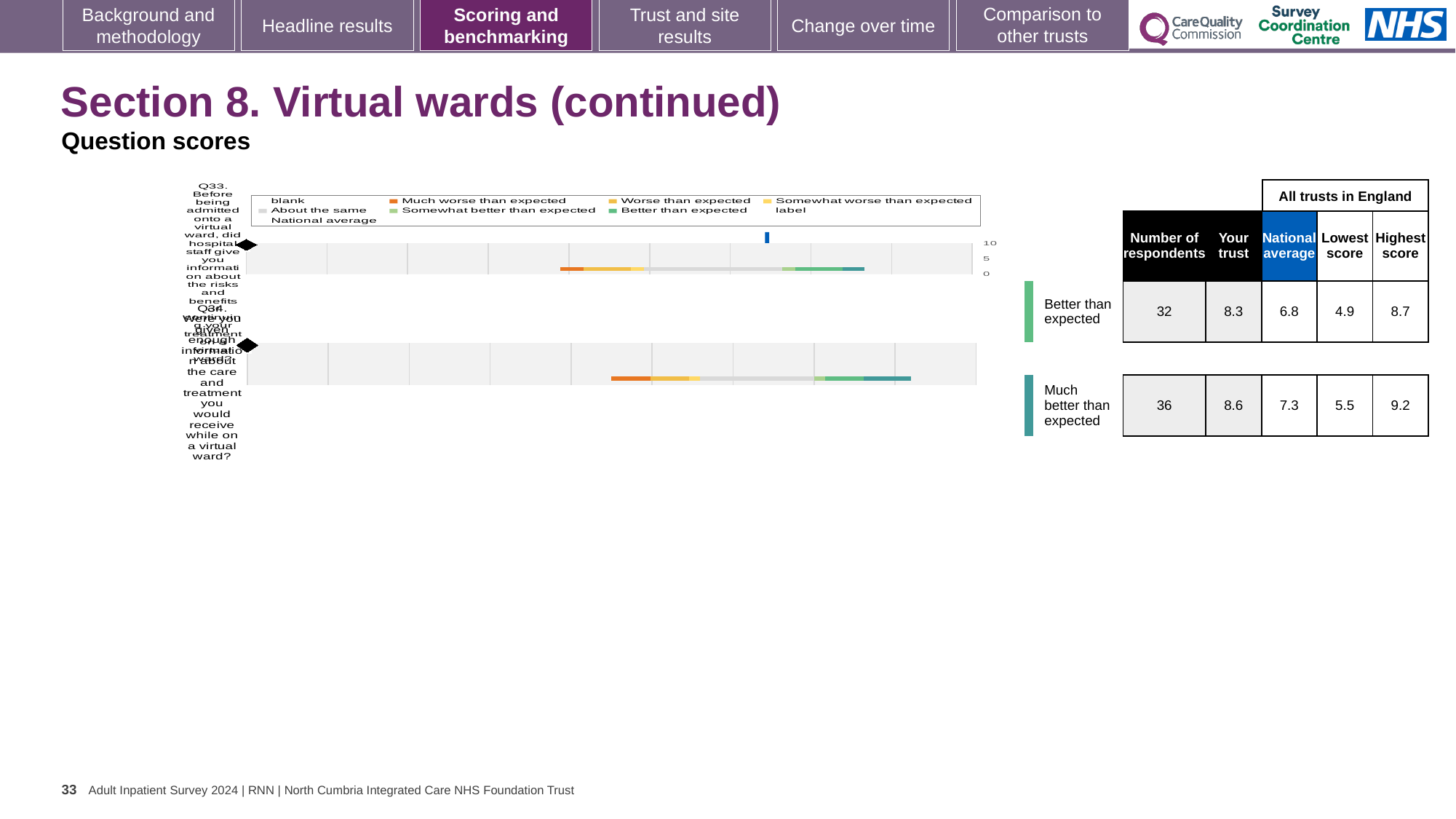
What kind of chart is shown on the slide? bar chart How many entries does the chart legend list? 9 Which question has the higher 'Your trust' score, Q33 or Q34? Q34 In the table beside the chart, how many respondents answered Q34? 36 In the table beside the chart, what is the national average for Q33? 6.8 In the table beside the chart, what is the highest score across all trusts in England for Q34? 9.2 Which legend entry is shown in orange in the chart? Much worse than expected What rating label is given to Q34 next to the chart? Much better than expected How many questions (bars) are plotted in the chart? 2 In the table beside the chart, what is the 'Your trust' score for Q33? 8.3 In the table beside the chart, what is the 'Your trust' score for Q34? 8.6 What is the difference between the 'Your trust' score and the national average for Q33? 1.5